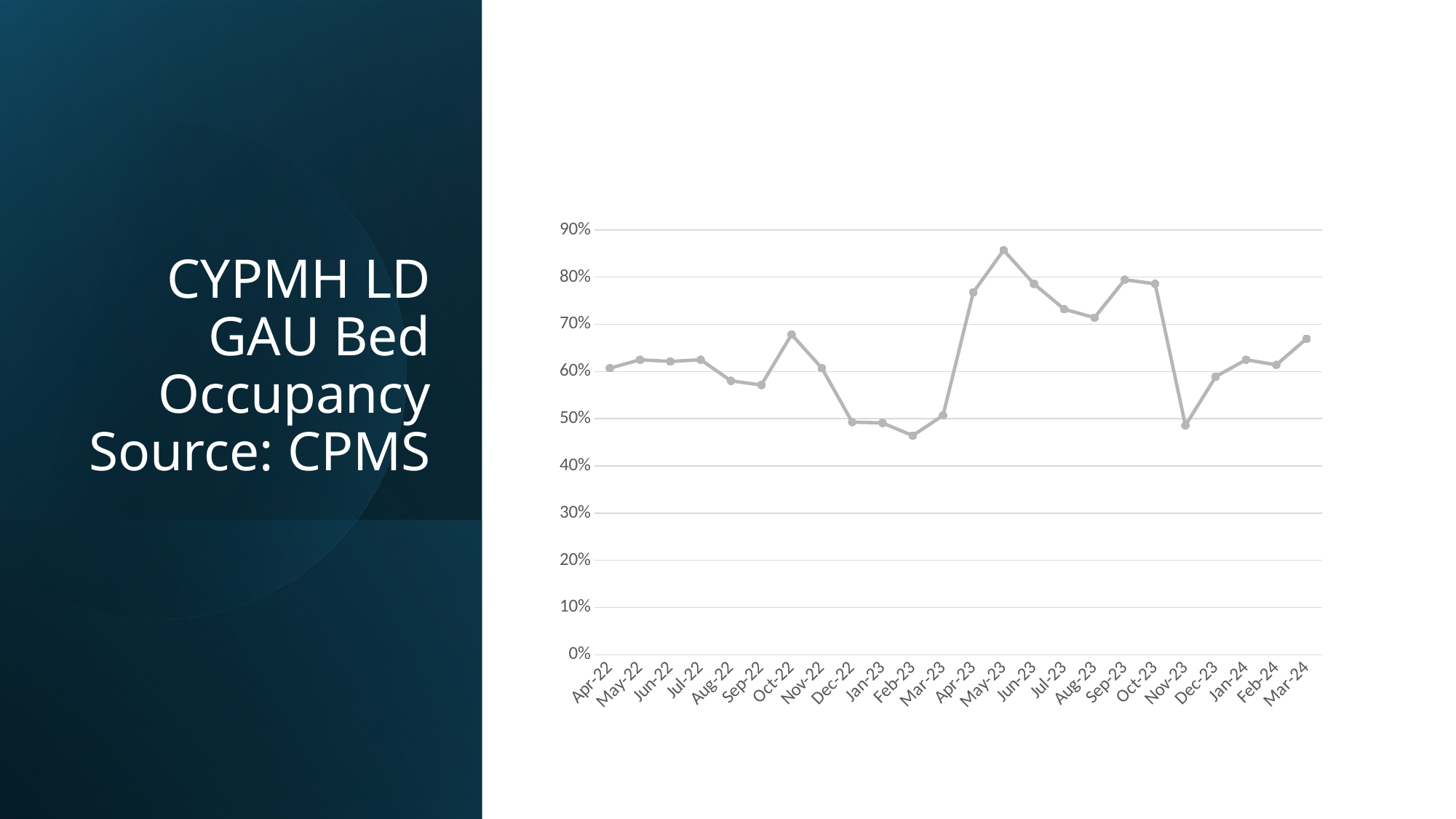
Which month has the lowest bed occupancy on the chart? Feb-23 Do the values rise or fall from Oct-22 to Feb-23? fall Is the value for May-23 greater or less than 80%? greater What kind of chart is shown on the slide? line chart What is the title shown on the slide for this chart? CYPMH LD GAU Bed Occupancy Source: CPMS Which month has the highest bed occupancy on the chart? May-23 Which is higher, the value for Oct-23 or the value for Nov-23? Oct-23 Which is higher, the value for Oct-22 or the value for Sep-22? Oct-22 Is the value for Oct-22 greater or less than 60%? greater How many monthly data points are plotted on the chart? 24 Is the value for Feb-23 greater or less than 50%? less